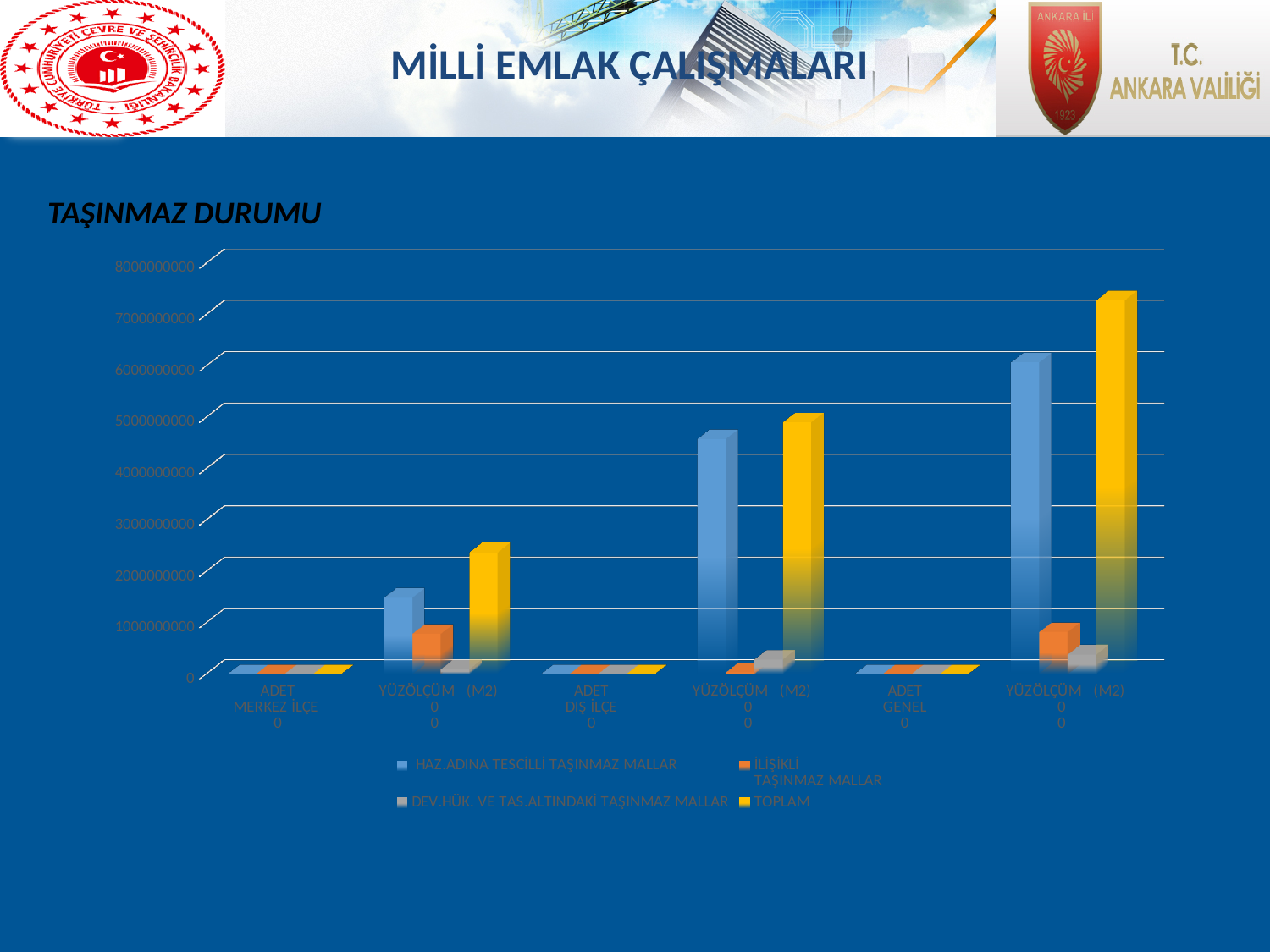
In the first YÜZÖLÇÜM (M2) category (after MERKEZ İLÇE), is the TOPLAM value greater or less than 2000000000? greater How many series does the chart legend list? 4 In the rightmost YÜZÖLÇÜM (M2) category, is the TOPLAM value greater or less than 7000000000? greater In the rightmost YÜZÖLÇÜM (M2) category, which is larger: TOPLAM or İLİŞİKLİ TAŞINMAZ MALLAR? TOPLAM What kind of chart is shown on the slide? bar chart How many categories are shown along the x axis of the chart? 6 In the rightmost YÜZÖLÇÜM (M2) category, is the HAZ.ADINA TESCİLLİ TAŞINMAZ MALLAR value greater or less than 5000000000? greater What is the title of the chart? TAŞINMAZ DURUMU Which series is shown in yellow in the chart legend? TOPLAM Which series has the tallest bar in the chart? TOPLAM